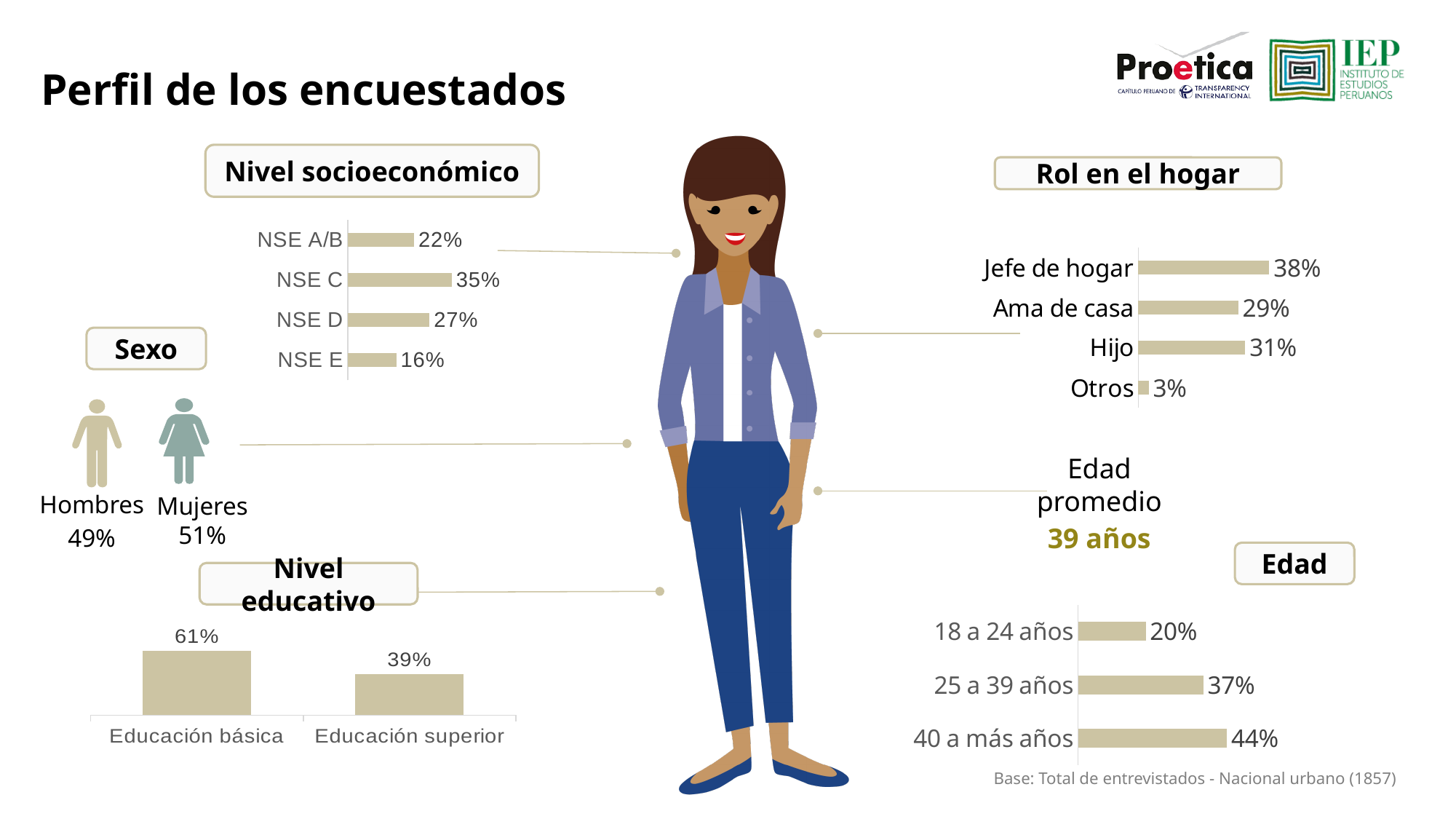
In the 'Rol en el hogar' chart, which category has the highest value? Jefe de hogar In the 'Rol en el hogar' chart, what is the value for Ama de casa? 29% In the 'Edad' chart, what is the difference between 40 a más años and 18 a 24 años? 24% In the 'Nivel educativo' chart, which is larger, Educación básica or Educación superior? Educación básica What type of chart is the 'Nivel educativo' chart? Bar chart In the 'Rol en el hogar' chart, what is the difference between Jefe de hogar and Otros? 35% In the 'Edad' chart, do the values rise or fall from the youngest to the oldest age group? Rise In the 'Nivel socioeconómico' chart, what is the value for NSE C? 35% In the 'Nivel educativo' chart, what is the value for Educación superior? 39% In the 'Nivel socioeconómico' chart, how many categories are shown? 4 In the 'Nivel socioeconómico' chart, which category has the lowest value? NSE E In the 'Edad' chart, what is the value for 25 a 39 años? 37%